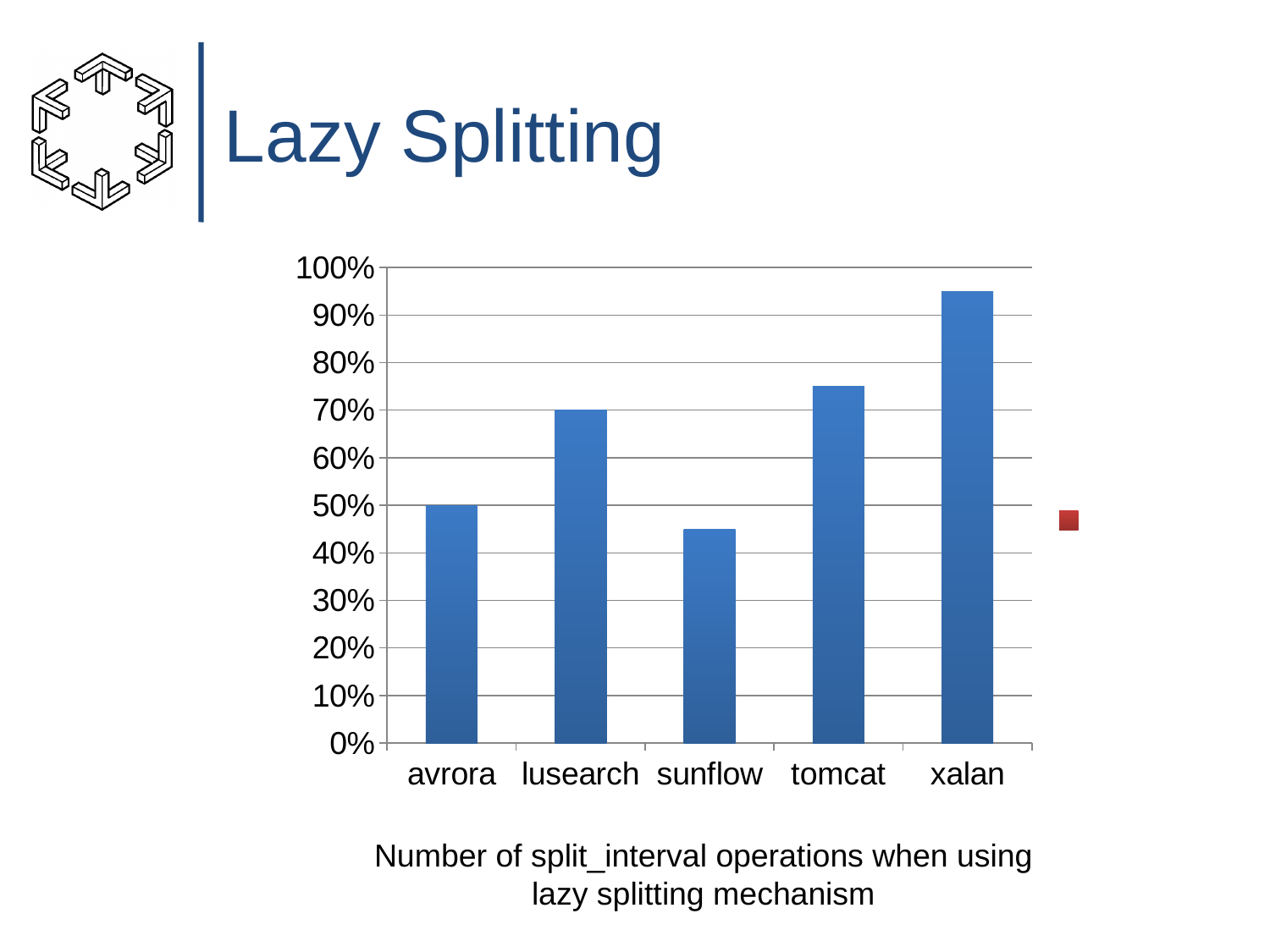
What is the value for avrora in the chart? 50% How many categories are shown on the x axis of the chart? 5 Which category has the highest bar in the chart? xalan Is the value for tomcat greater or less than 70%? greater What caption is shown below the chart? Number of split_interval operations when using lazy splitting mechanism Which is larger, the value for tomcat or the value for lusearch? tomcat What is the difference between the values for lusearch and avrora? 20% Which category has the lowest bar in the chart? sunflow What type of chart is shown on the slide? bar chart Is the value for sunflow greater or less than 50%? less What is the value for lusearch in the chart? 70% Is the value for xalan greater or less than 90%? greater